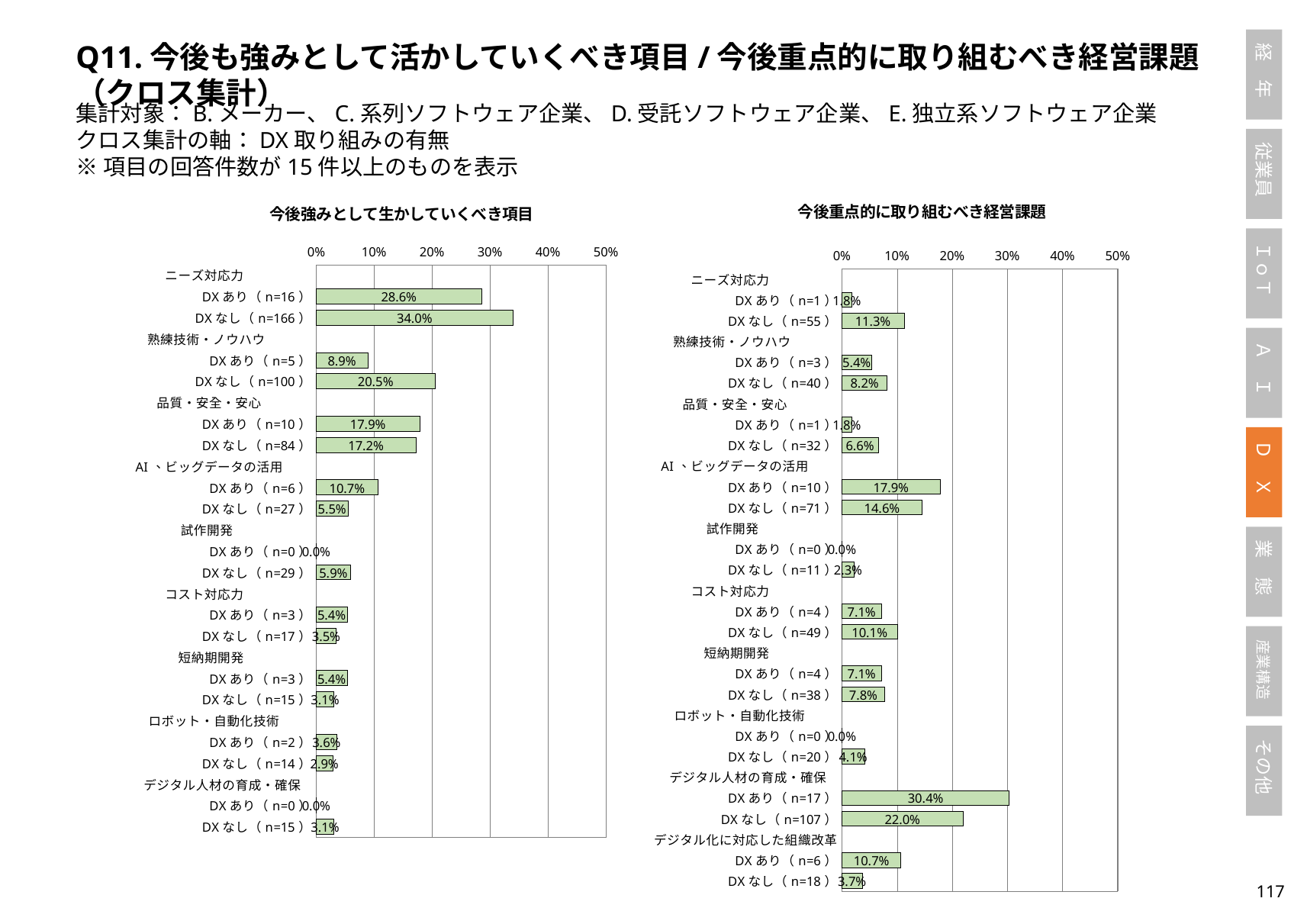
In the right chart (今後重点的に取り組むべき経営課題), what is the value for デジタル化に対応した組織改革 DXなし (n=18)? 3.7% In the right chart (今後重点的に取り組むべき経営課題), is the value for ニーズ対応力 DXなし (n=55) greater or less than 10%? greater In the left chart (今後強みとして生かしていくべき項目), what is the value for 熟練技術・ノウハウ DXあり (n=5)? 8.9% In the right chart (今後重点的に取り組むべき経営課題), what is the difference between デジタル人材の育成・確保 DXあり (30.4%) and DXなし (22.0%)? 8.4% In the right chart (今後重点的に取り組むべき経営課題), what is the value for デジタル人材の育成・確保 DXあり (n=17)? 30.4% What type of chart is used on this slide? Bar chart In the left chart (今後強みとして生かしていくべき項目), what is the value for ニーズ対応力 DXなし (n=166)? 34.0% In the left chart (今後強みとして生かしていくべき項目), which bar has the highest value? ニーズ対応力 DXなし (n=166) In the left chart (今後強みとして生かしていくべき項目), what is the difference between ニーズ対応力 DXなし (34.0%) and DXあり (28.6%)? 5.4% How many item groups (categories) are shown in the right chart (今後重点的に取り組むべき経営課題)? 10 In the right chart (今後重点的に取り組むべき経営課題), which bar has the highest value? デジタル人材の育成・確保 DXあり (n=17) In the left chart (今後強みとして生かしていくべき項目), which is larger: AI、ビッグデータの活用 DXあり or DXなし? DXあり